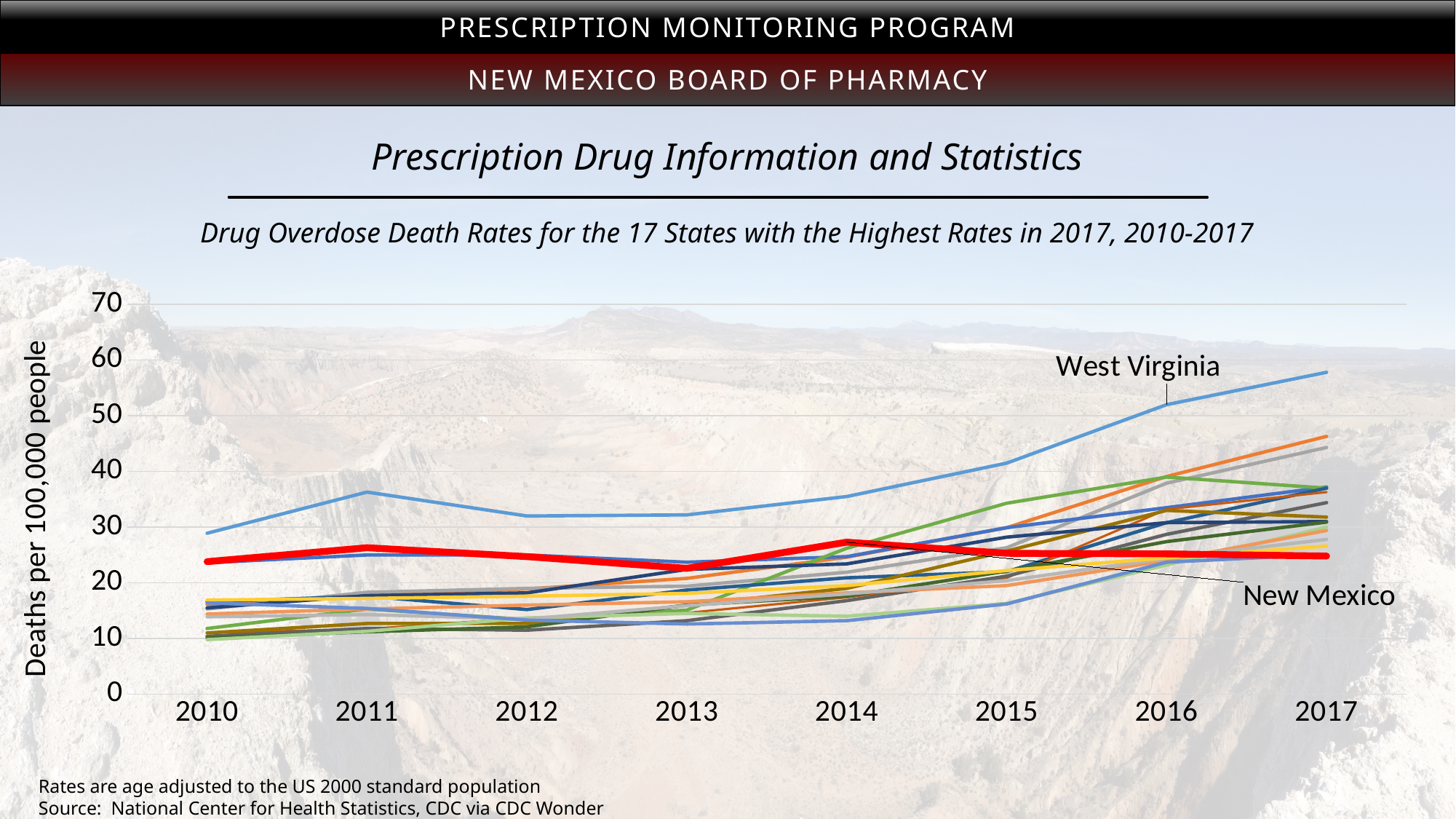
What is the label of the y axis? Deaths per 100,000 people Is the value for New Mexico in 2014 greater or less than 20? greater According to the chart title, how many states are plotted? 17 Is the value for West Virginia in 2017 greater or less than 50? greater Which of the two labeled states, West Virginia or New Mexico, has the higher value in 2017? West Virginia Is the value for New Mexico in 2017 greater or less than 30? less How many years are shown along the x axis of the chart? 8 In which year does the West Virginia line reach its highest value? 2017 What kind of chart is shown on the slide? line chart Does the West Virginia line rise or fall overall from 2010 to 2017? rise